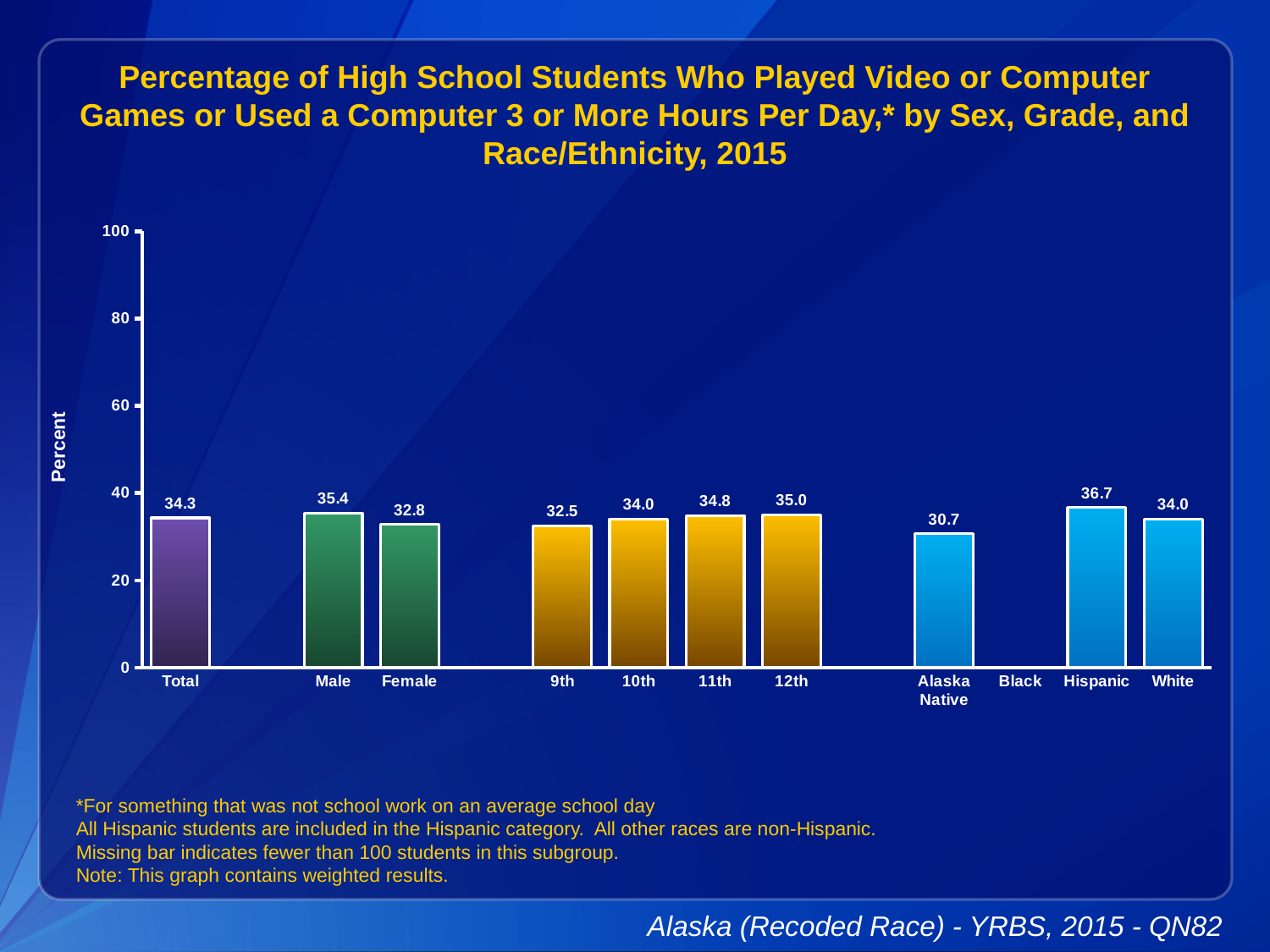
Which is larger, the value for 9th or the value for 12th? 12th Is the value for Hispanic greater or less than 40? less What kind of chart is shown? bar chart Do the values rise or fall from 9th grade to 12th grade? rise Which category has no bar shown? Black Which category has the lowest value among the bars shown? Alaska Native How many bars are plotted on the chart? 10 What is the value for Total? 34.3 What is the value for Male? 35.4 What is the difference between the Male and Female values? 2.6 What is the value for Alaska Native? 30.7 Which category has the highest value? Hispanic